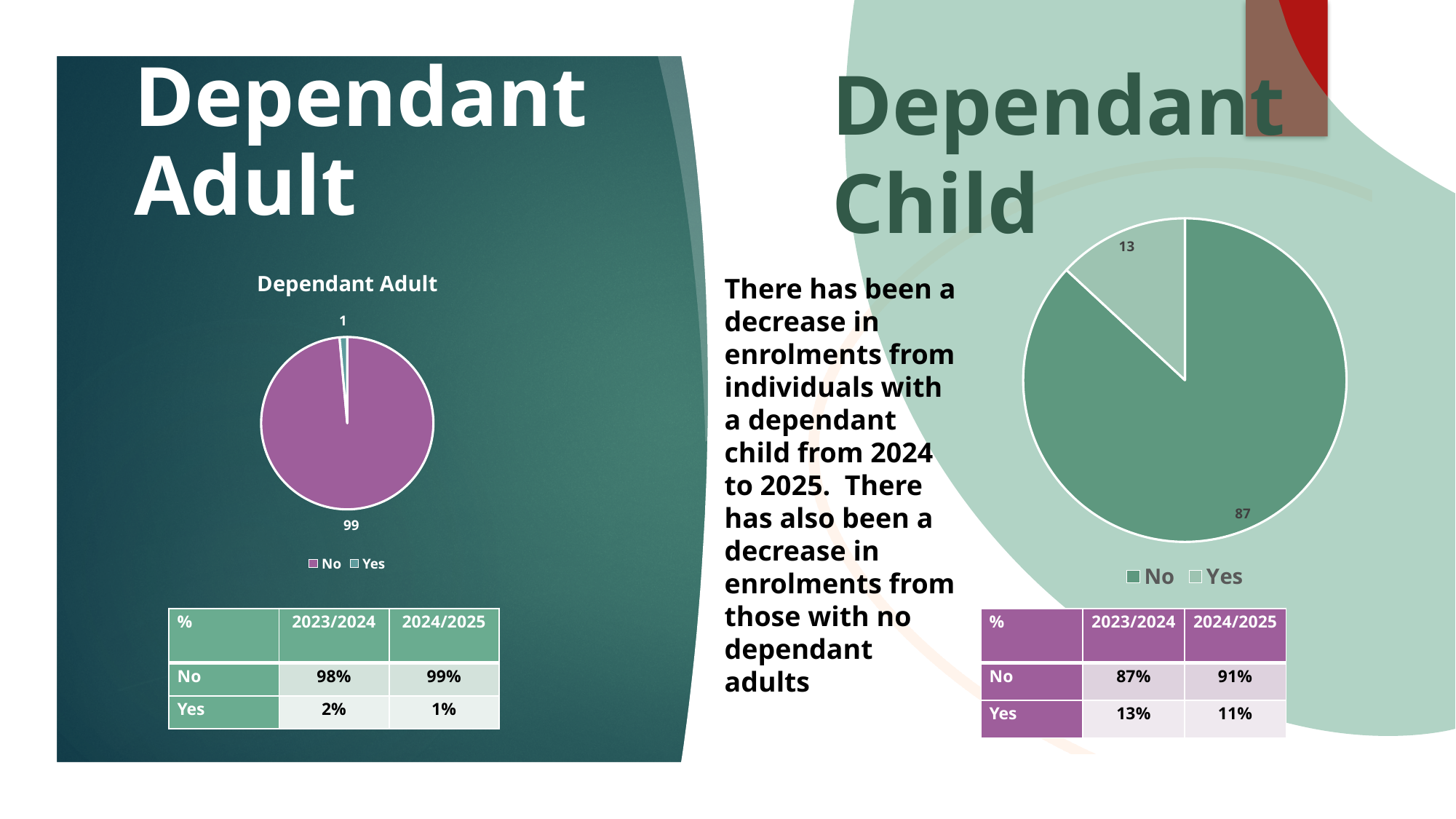
In the Dependant Adult pie chart, what is the value for No? 99 In the pie chart on the right side of the slide (Dependant Child), what is the difference between the No and Yes values? 74 In the pie chart on the right side of the slide (Dependant Child), what is the value for Yes? 13 What kind of chart is shown on the left side of the slide under the Dependant Adult heading? Pie chart In the pie chart on the right side of the slide (Dependant Child), what share of the pie does the Yes slice represent? 13% How many entries does the legend of the Dependant Adult pie chart list? 2 Which is larger: the Yes value in the Dependant Adult pie chart or the Yes value in the Dependant Child pie chart? Dependant Child In the pie chart on the right side of the slide (Dependant Child), what is the value for No? 87 In the Dependant Adult pie chart, what is the difference between the No and Yes values? 98 In the Dependant Adult pie chart, which slice is the largest? No In the pie chart on the right side of the slide (Dependant Child), which slice is the smallest? Yes In the Dependant Adult pie chart, what is the value for Yes? 1